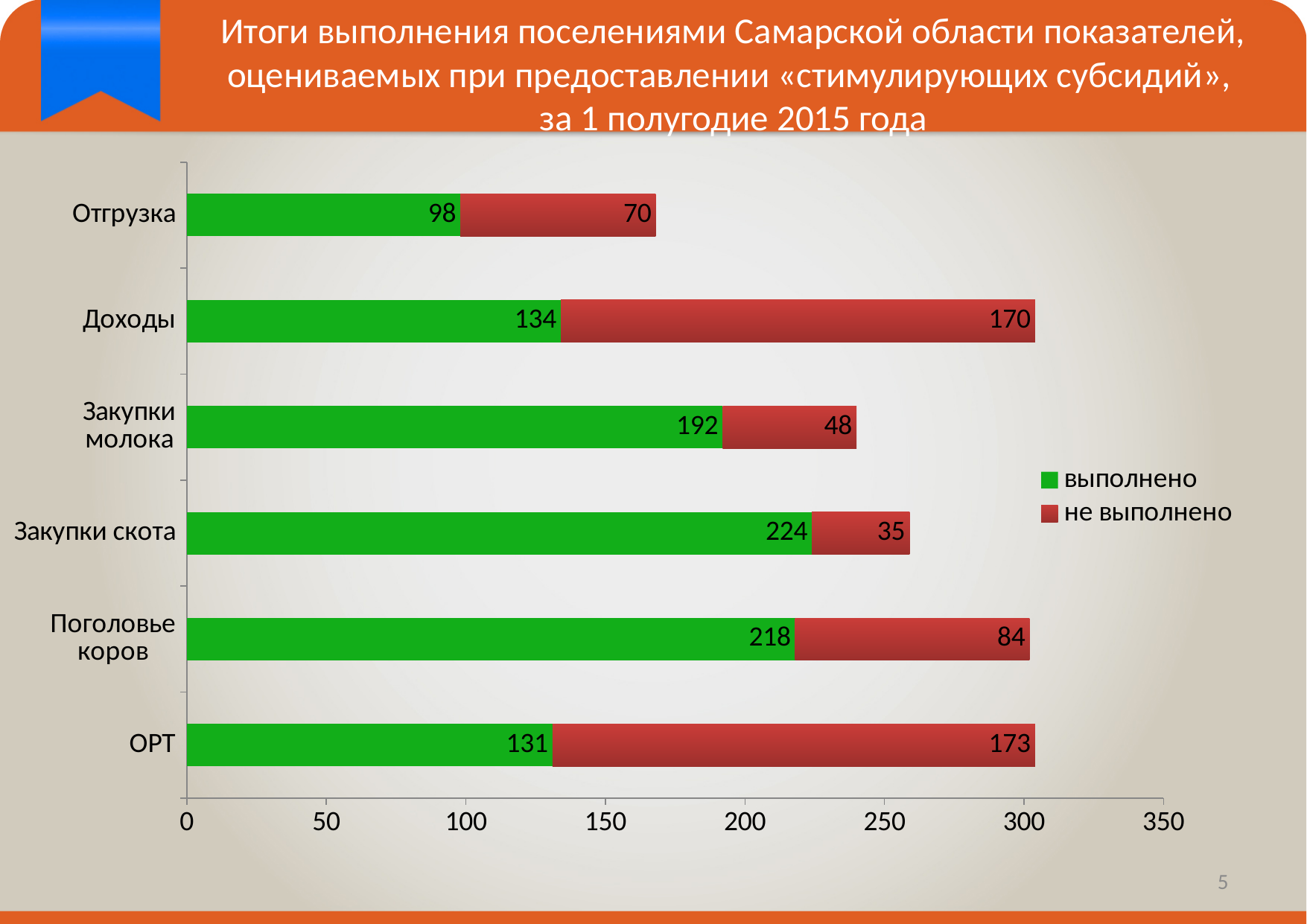
What is the total of the stacked bar for Отгрузка? 168 What is the value of "выполнено" for Закупки скота? 224 What kind of chart is shown on the slide? Stacked bar chart What is the total of the stacked bar for Поголовье коров? 302 How many series does the legend list? 2 Which category has the highest "выполнено" value? Закупки скота What is the value of "выполнено" for ОРТ? 131 Which category has the lowest "не выполнено" value? Закупки скота Which is larger: the "выполнено" value for Закупки молока or for Доходы? Закупки молока What is the difference between the "не выполнено" values for ОРТ and Отгрузка? 103 What is the value of "не выполнено" for Доходы? 170 How many categories are shown on the chart? 6